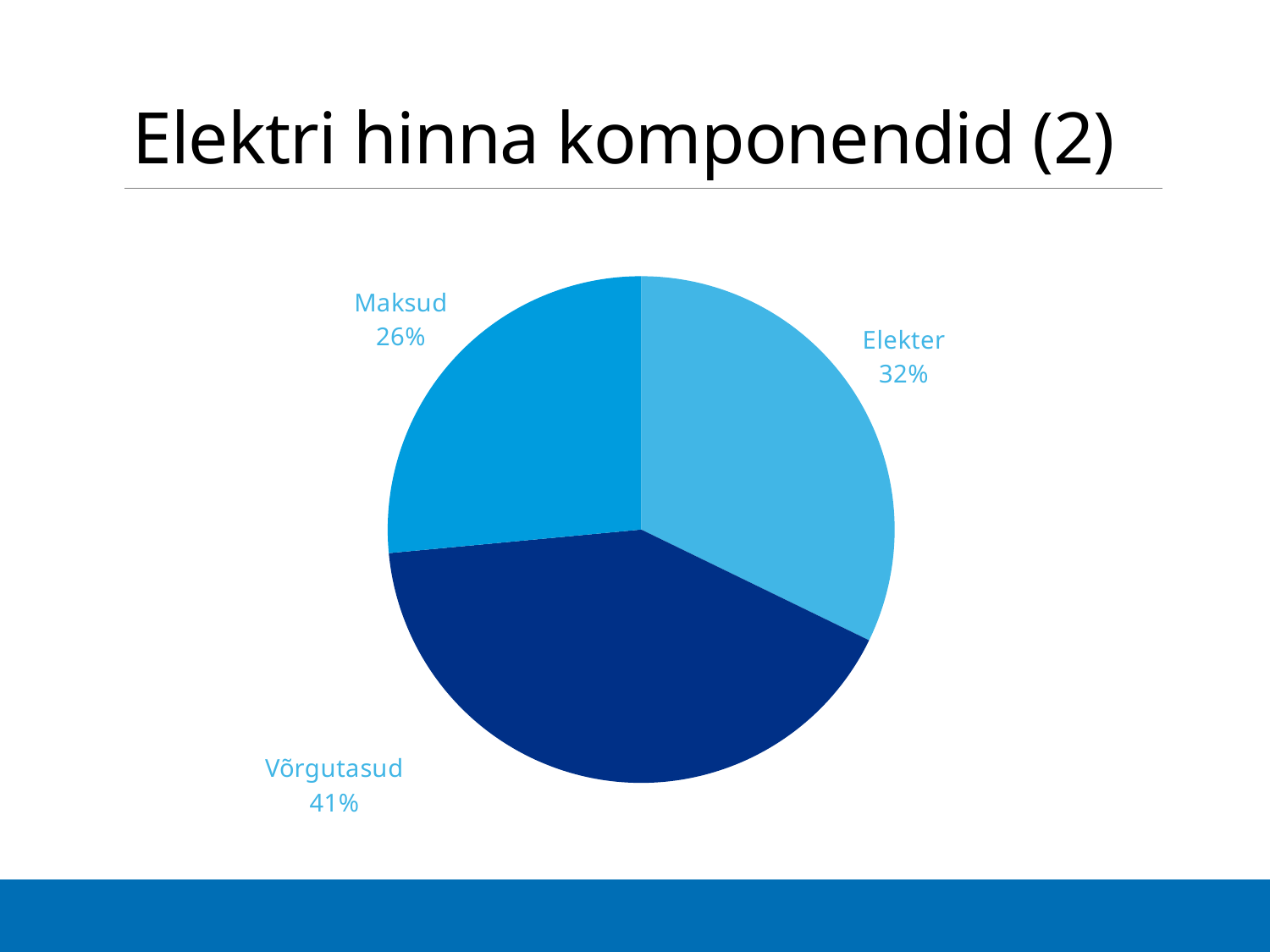
What is the difference in percentage points between Elekter and Maksud? 6 What is the difference in percentage points between Võrgutasud and Maksud? 15 Which slice of the pie is coloured dark navy blue? Võrgutasud What is the title of the slide containing the pie chart? Elektri hinna komponendid (2) How many slices does the pie chart have? 3 Which slice of the pie is the smallest? Maksud What kind of chart is shown on the slide? pie chart Which slice of the pie is the largest? Võrgutasud What share of the pie does Maksud take? 26% What share of the pie does Elekter take? 32% Which is larger, the Elekter slice or the Maksud slice? Elekter What share of the pie does Võrgutasud take? 41%